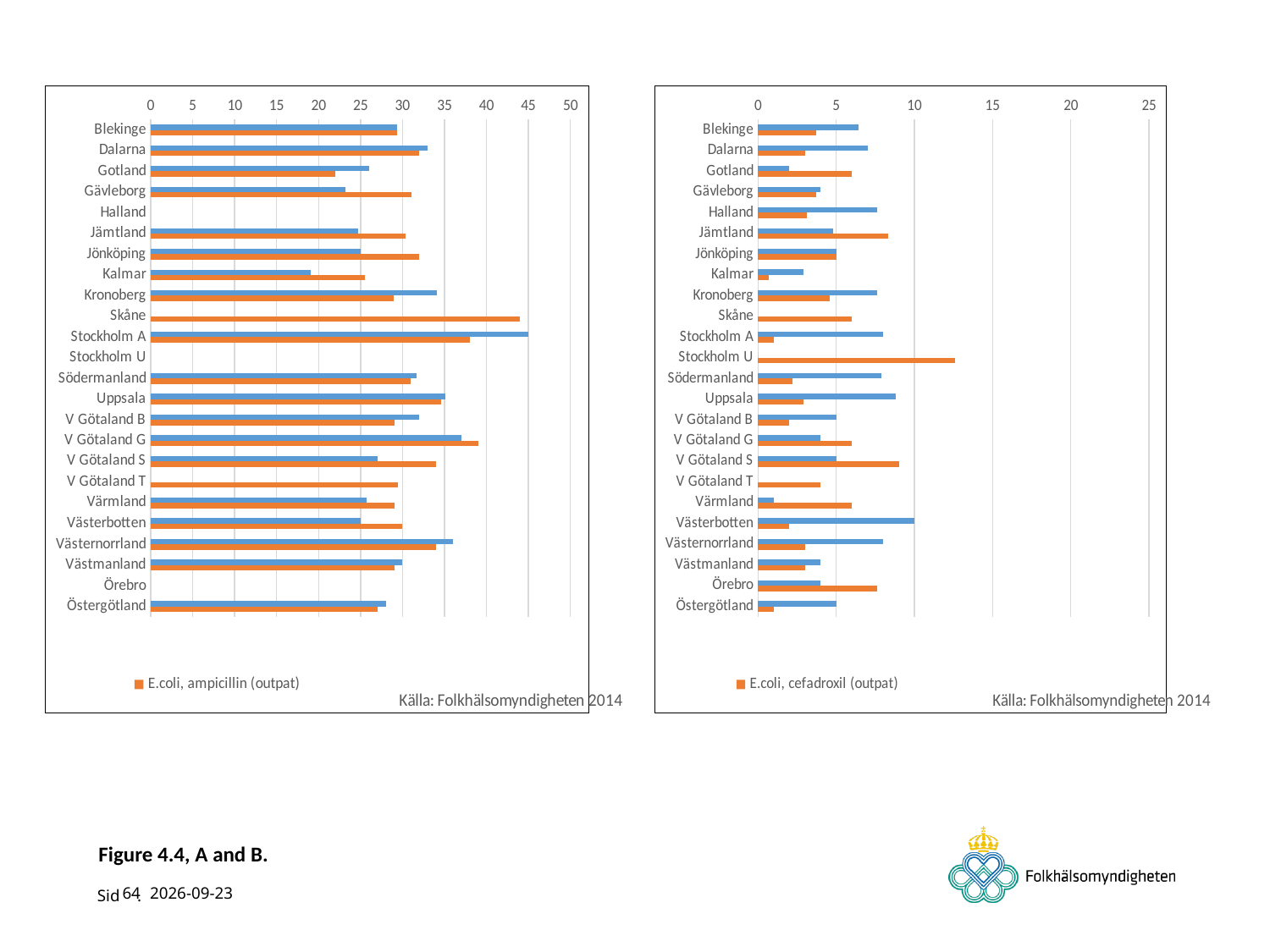
What source is cited below the left chart? Källa: Folkhälsomyndigheten 2014 In the right chart (E.coli, cefadroxil (outpat)), is the E.coli, cefadroxil (outpat) value for Östergötland greater or less than 5? less In the left chart (E.coli, ampicillin (outpat)), is the E.coli, ampicillin (outpat) value for Skåne greater or less than 40? greater In the left chart (E.coli, ampicillin (outpat)), is the E.coli, ampicillin (outpat) value for Gotland greater or less than 25? less In the left chart (E.coli, ampicillin (outpat)), which has the larger E.coli, ampicillin (outpat) value, Skåne or Gotland? Skåne In the right chart (E.coli, cefadroxil (outpat)), which region has the highest E.coli, cefadroxil (outpat) value? Stockholm U In the left chart (E.coli, ampicillin (outpat)), which region has the highest E.coli, ampicillin (outpat) value? Skåne How many series does the legend of the right chart list? 1 In the right chart (E.coli, cefadroxil (outpat)), which has the larger E.coli, cefadroxil (outpat) value, Stockholm U or Kalmar? Stockholm U In the left chart (E.coli, ampicillin (outpat)), how many regions are listed on the vertical axis? 24 What kind of chart is the left chart (E.coli, ampicillin (outpat))? bar chart